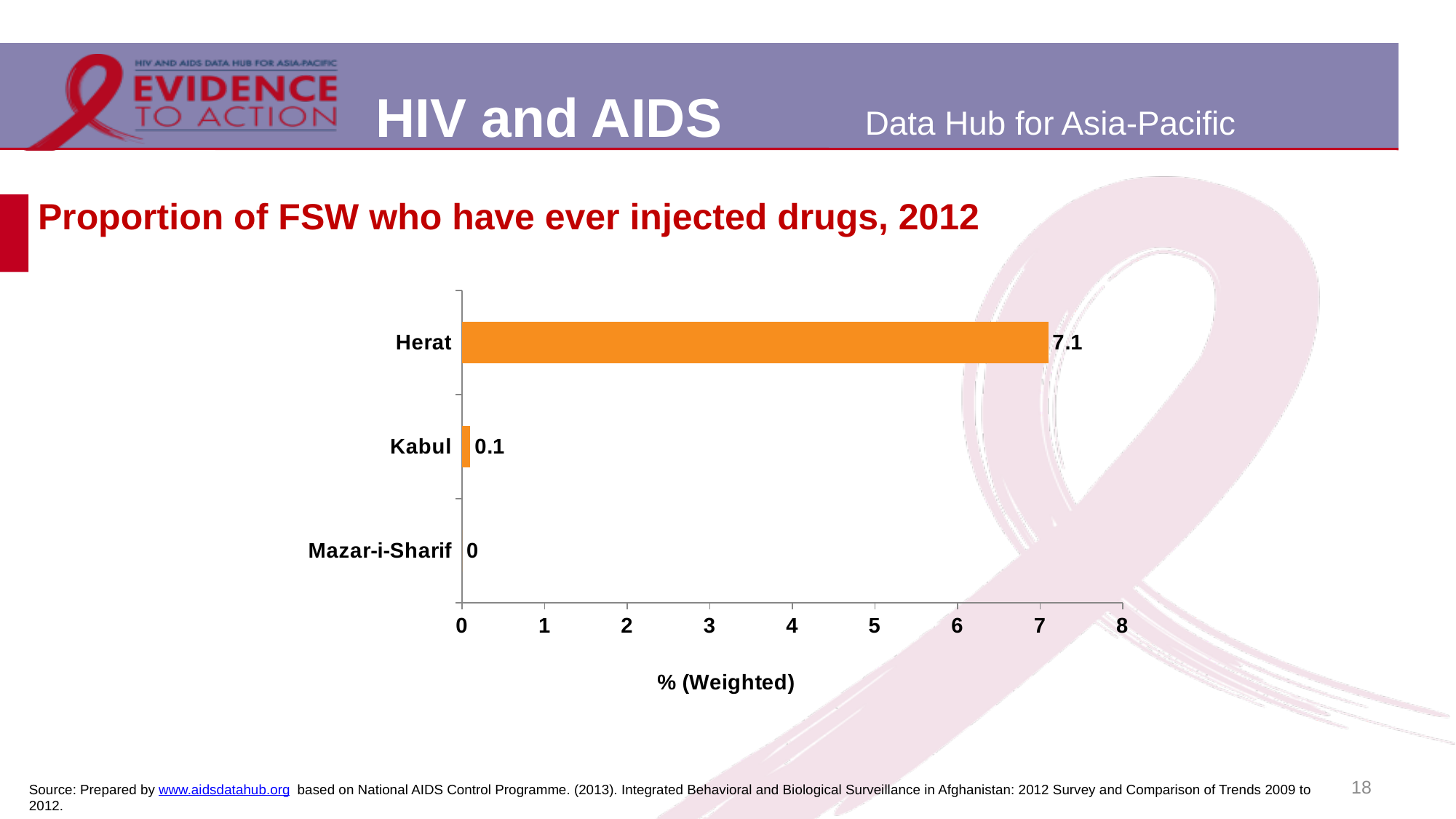
What is the title of the chart? Proportion of FSW who have ever injected drugs, 2012 What kind of chart is shown on the slide? Bar chart What is the value for Mazar-i-Sharif? 0 How many cities are shown in the chart? 3 What is the value for Kabul? 0.1 What is the difference between the values for Herat and Kabul? 7 Which city has the highest proportion of FSW who have ever injected drugs? Herat Is the value for Herat greater or less than 5? greater Which is larger, the value for Herat or the value for Kabul? Herat Which city has the lowest proportion of FSW who have ever injected drugs? Mazar-i-Sharif What is the value for Herat? 7.1 What is the label of the horizontal axis? % (Weighted)